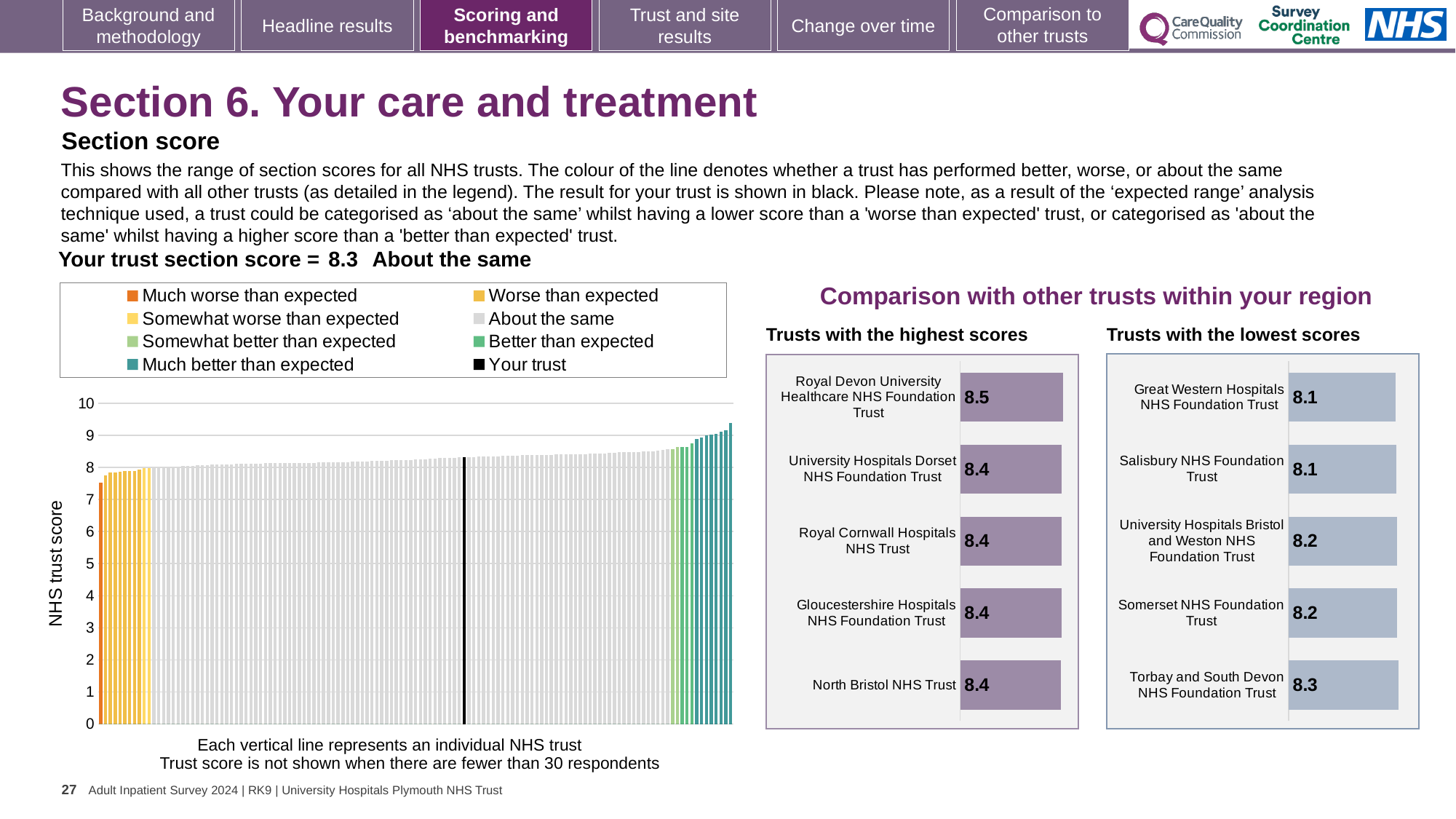
In the large chart on the left, do the trust scores rise or fall from left to right? rise In the 'Trusts with the highest scores' chart, what is the value for Royal Devon University Healthcare NHS Foundation Trust? 8.5 In the 'Trusts with the lowest scores' chart, which trust has the highest score? Torbay and South Devon NHS Foundation Trust In the 'Trusts with the highest scores' chart, what is the difference between Royal Devon University Healthcare NHS Foundation Trust and North Bristol NHS Trust? 0.1 In the 'Trusts with the highest scores' chart, how many trusts are listed? 5 In the large chart on the left, how many entries does the legend list? 8 In the 'Trusts with the highest scores' chart, which trust has the highest score? Royal Devon University Healthcare NHS Foundation Trust In the 'Trusts with the lowest scores' chart, what is the value for Torbay and South Devon NHS Foundation Trust? 8.3 In the large chart on the left, is the value for the black 'Your trust' line greater or less than 8? greater In the large chart on the left, what is the highest value shown on the y axis? 10 In the 'Trusts with the lowest scores' chart, which is larger: the value for Torbay and South Devon NHS Foundation Trust or Somerset NHS Foundation Trust? Torbay and South Devon NHS Foundation Trust What kind of chart is the large chart on the left showing NHS trust scores? bar chart